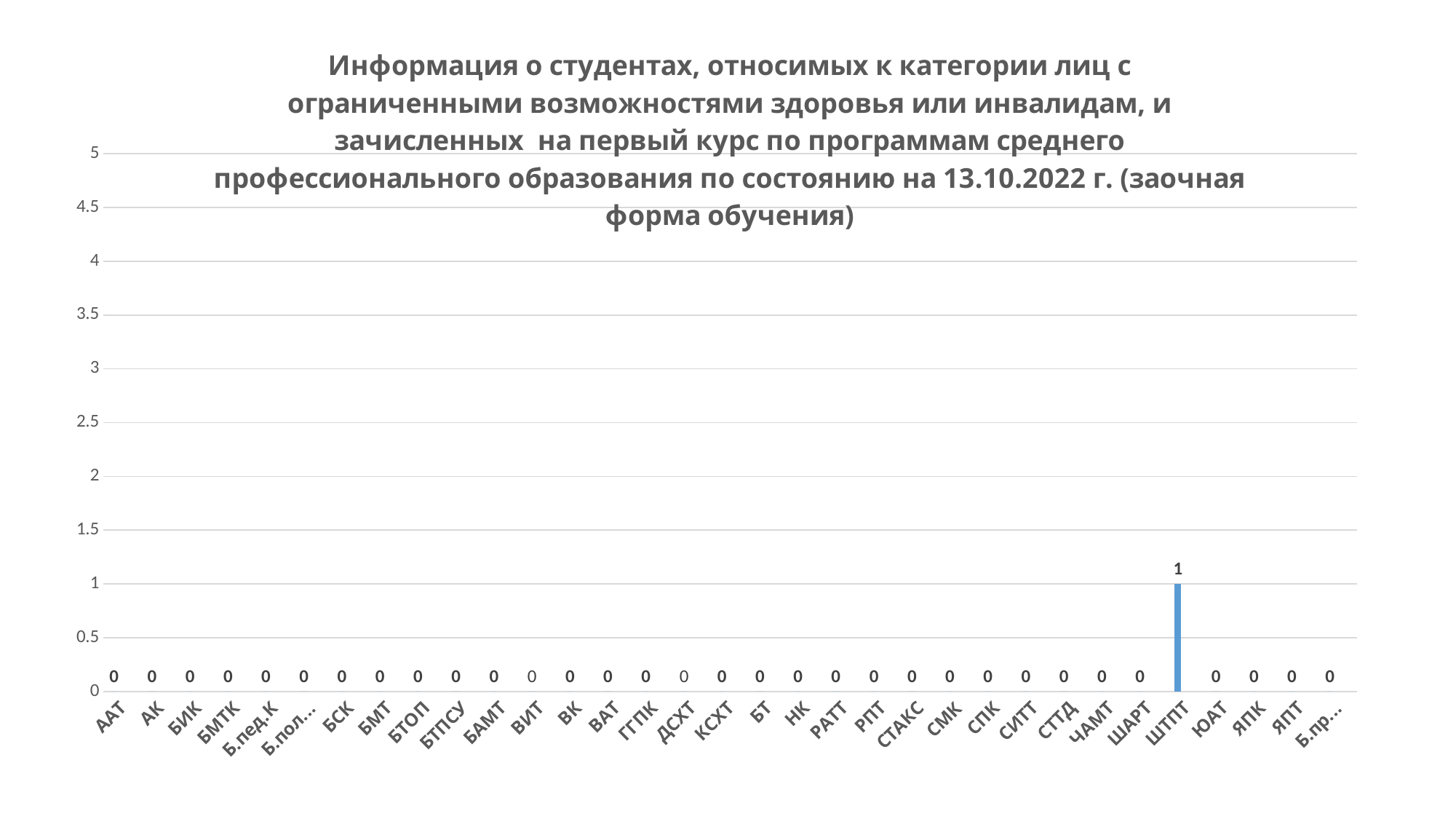
What is the value for СМК? 0 What kind of chart is this? bar chart How many categories are shown on the x axis? 33 What is the value for ААТ? 0 Which category has the highest value? ШТПТ What colour is the bar for ШТПТ? blue Is the value for ШТПТ greater or less than 2? less What is the difference between the values for ШТПТ and ШАРТ? 1 Which is larger, the value for ШТПТ or the value for ЯПК? ШТПТ What is the value for ЮАТ? 0 What is the maximum value shown on the y axis? 5 What is the value for ШТПТ? 1